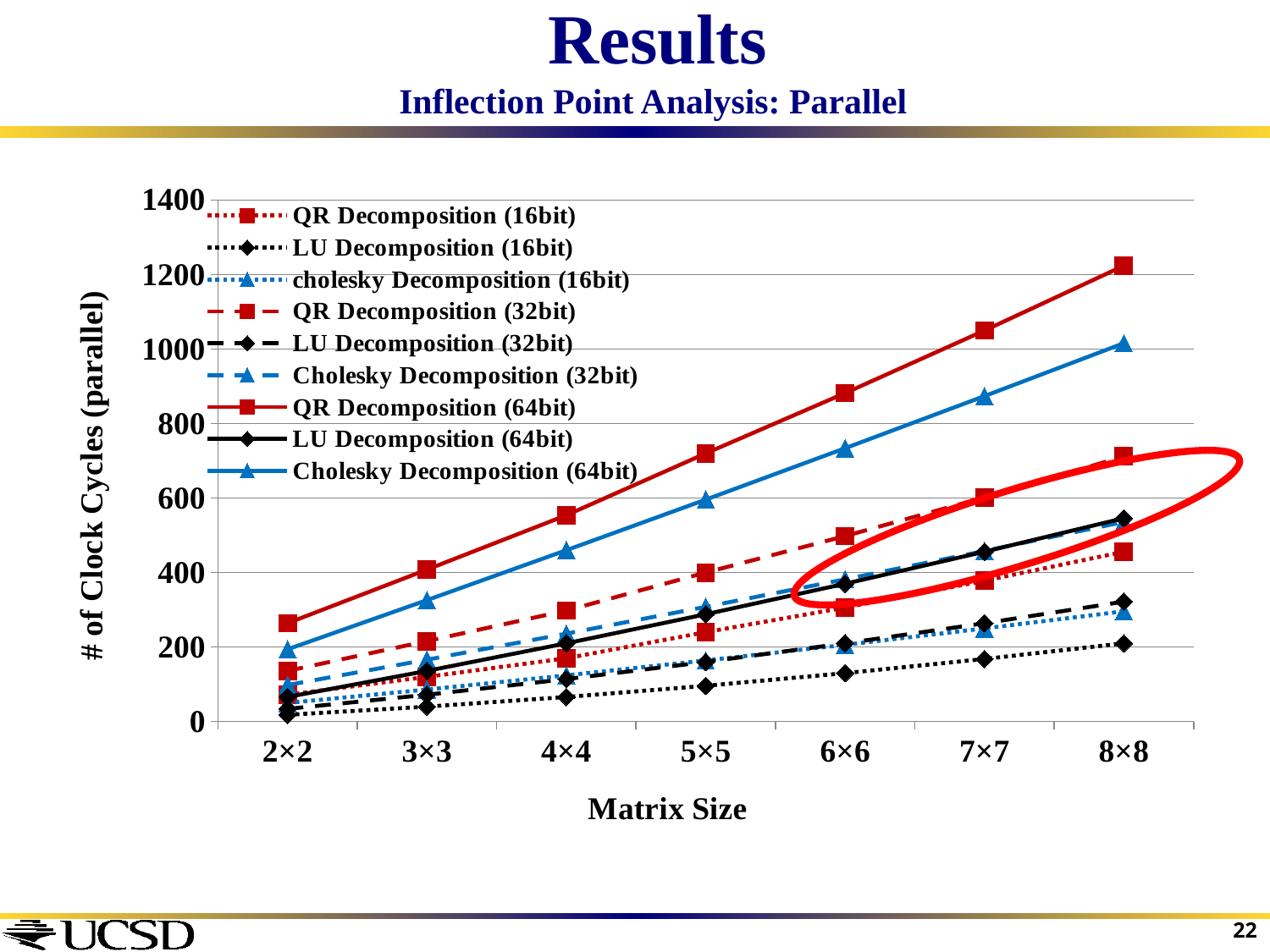
How many series does the legend list? 9 Is the value for QR Decomposition (64bit) at 8×8 greater or less than 1000? greater At matrix size 8×8, which is larger: QR Decomposition (64bit) or Cholesky Decomposition (64bit)? QR Decomposition (64bit) What is the title of the x axis? Matrix Size How many matrix sizes are plotted along the x axis? 7 Which series has the lowest value at matrix size 8×8? LU Decomposition (16bit) Is the value for Cholesky Decomposition (64bit) at 8×8 greater or less than 800? greater Do the values for QR Decomposition (64bit) rise or fall as the matrix size increases from 2×2 to 8×8? rise What kind of chart is shown on the slide? line chart Which series has the highest value at matrix size 8×8? QR Decomposition (64bit) Is the value for LU Decomposition (16bit) at 8×8 greater or less than 400? less What is the title of the y axis? # of Clock Cycles (parallel)